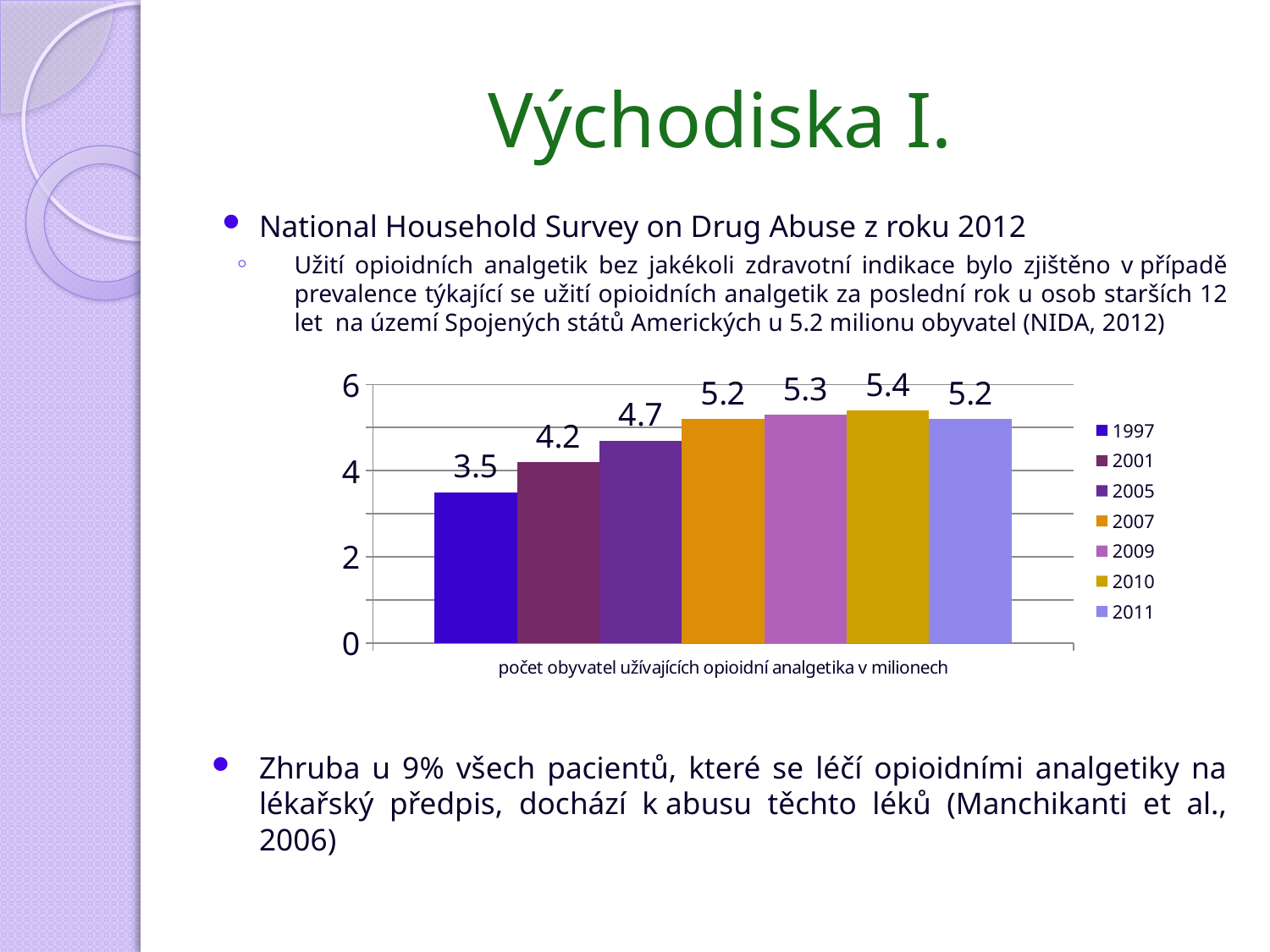
What is the value for 1997 in the chart? 3.5 Which year has the highest value in the chart? 2010 Which year has the lowest value in the chart? 1997 How many series does the legend list? 7 What is the value for 2011 in the chart? 5.2 What is the label shown below the bars on the x axis? počet obyvatel užívajících opioidní analgetika v milionech What is the value for 2005 in the chart? 4.7 What kind of chart is shown on the slide? bar chart What is the difference between the values for 2010 and 1997? 1.9 What is the value for 2010 in the chart? 5.4 Is the value for 1997 greater or less than 4? less Which is larger, the value for 2001 or the value for 2005? 2005